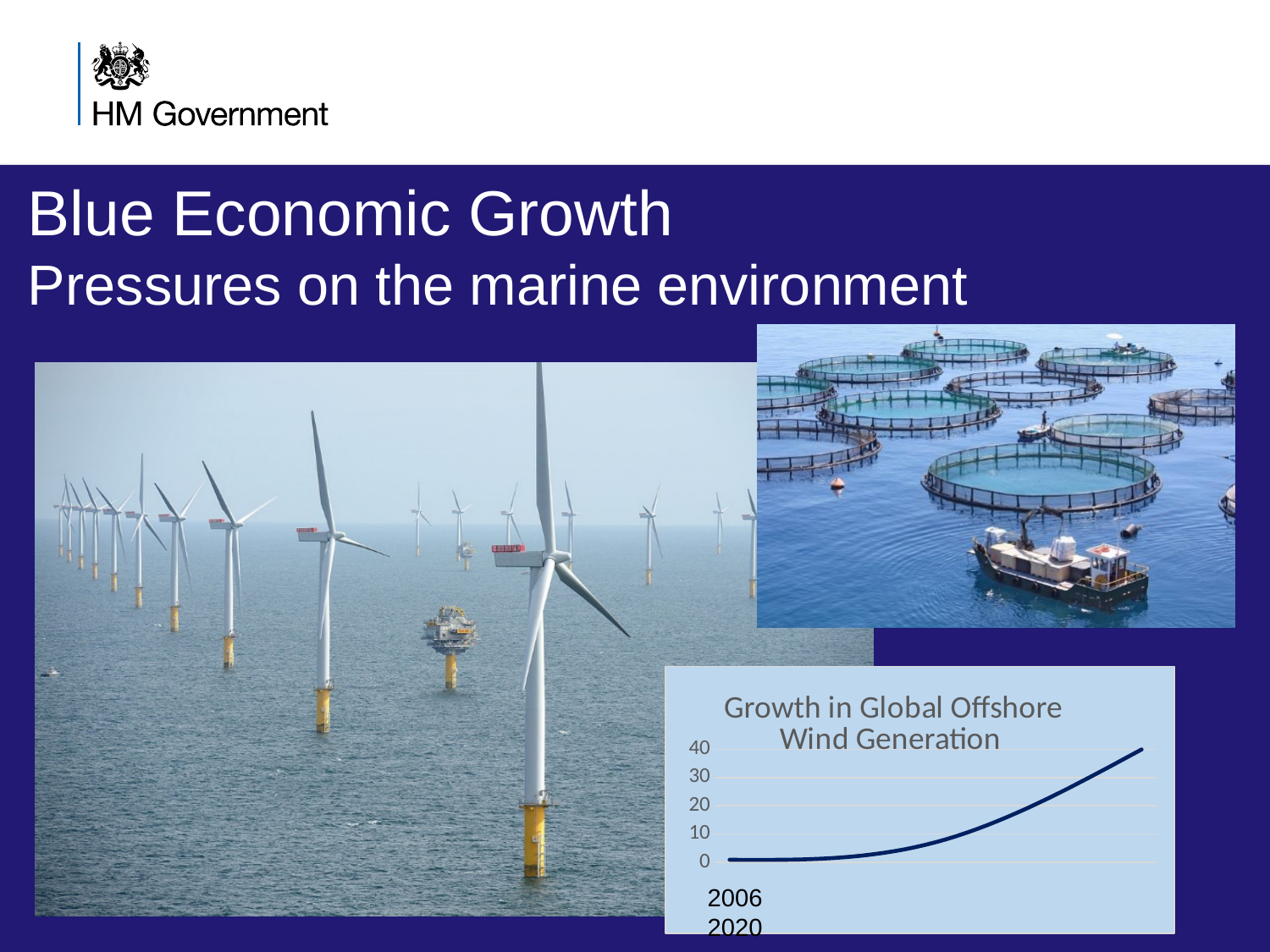
Which year labelled on the x axis has the lowest value in the Growth in Global Offshore Wind Generation chart? 2006 What is the highest tick value shown on the y axis of the Growth in Global Offshore Wind Generation chart? 40 Which year labelled on the x axis has the highest value in the Growth in Global Offshore Wind Generation chart? 2020 In the Growth in Global Offshore Wind Generation chart, is the value for 2020 greater or less than 30? greater What kind of chart is shown on the slide? line chart Do the values in the Growth in Global Offshore Wind Generation chart rise or fall from 2006 to 2020? rise In the Growth in Global Offshore Wind Generation chart, is the value for 2006 greater or less than 10? less In the Growth in Global Offshore Wind Generation chart, is the value for 2020 greater or less than 20? greater What is the title of the chart on the slide? Growth in Global Offshore Wind Generation Which year shown on the x axis of the Growth in Global Offshore Wind Generation chart has the higher value, 2006 or 2020? 2020